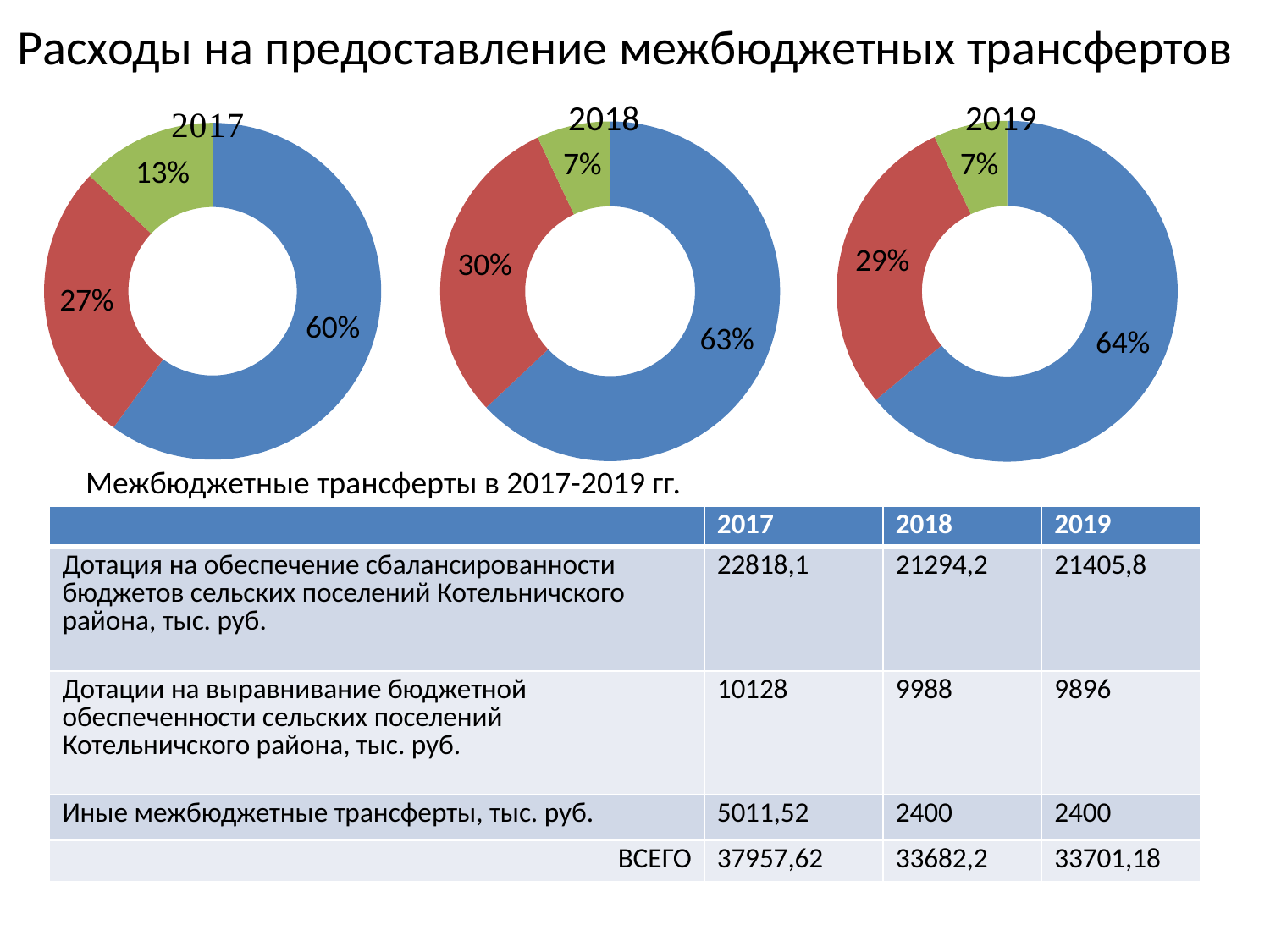
In the 2018 chart, what is the share of the largest slice? 63% What is the title of the middle chart? 2018 In the 2017 chart, what share is shown for the green slice? 13% Which chart has the larger red slice, 2017 or 2018? 2018 In the 2017 chart, what is the share of the largest slice? 60% In the 2018 chart, how many slices does the doughnut have? 3 What kind of chart is the 2017 chart on the left? doughnut chart Does the share of the largest slice rise or fall from the 2017 chart to the 2019 chart? rises By how many percentage points is the largest slice in the 2019 chart bigger than the largest slice in the 2017 chart? 4 How many charts are shown on the slide? 3 In the 2017 chart, what is the share of the smallest slice? 13% In the 2019 chart, what is the share of the smallest slice? 7%